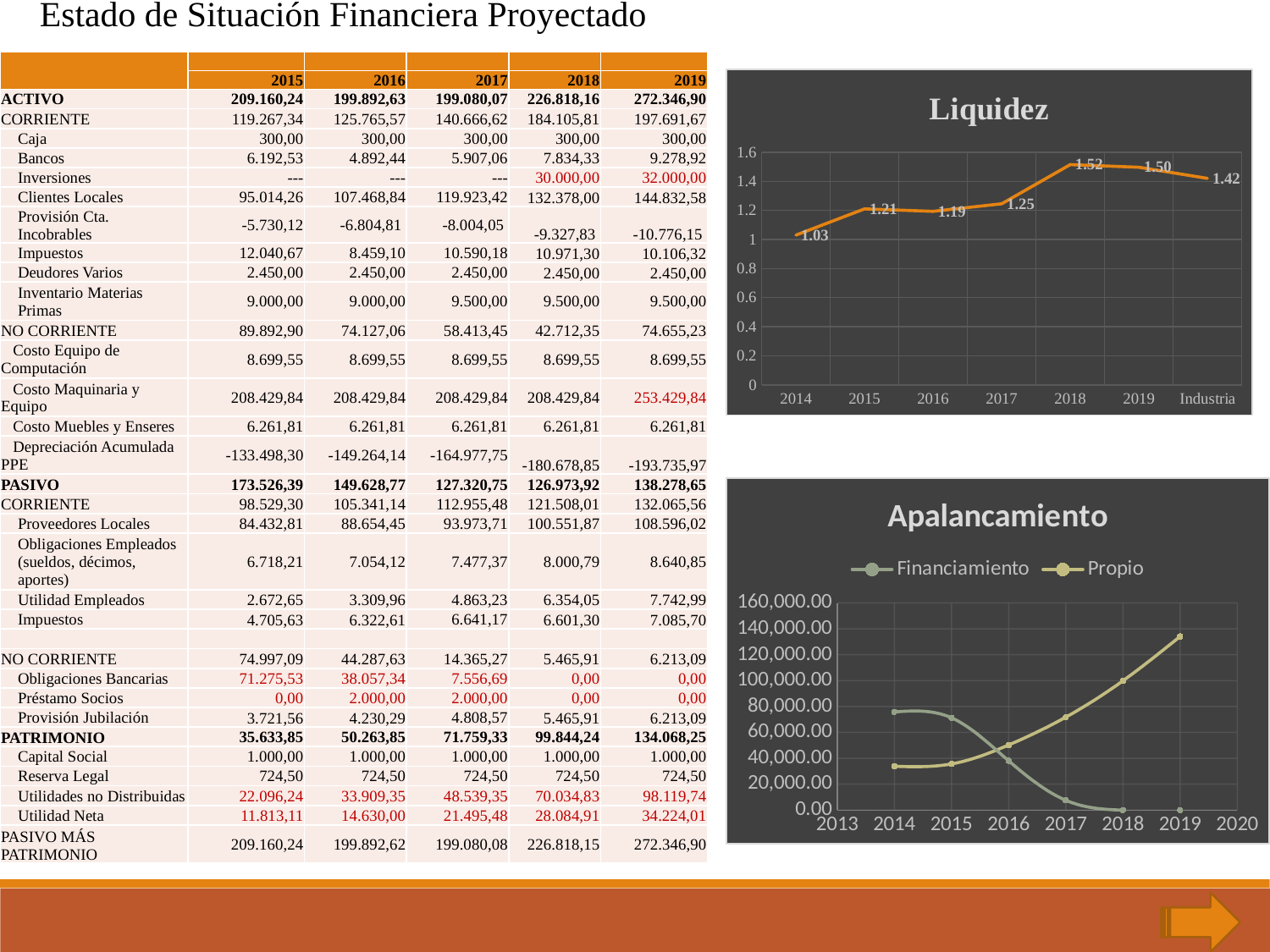
In the Liquidez chart, which is larger, the value for 2016 or the value for 2017? 2017 In the Liquidez chart, which category has the lowest value? 2014 In the Apalancamiento chart, how many series does the legend list? 2 What kind of chart is the Apalancamiento chart? Line chart In the Liquidez chart, which category has the highest value? 2018 In the Liquidez chart, what is the value for Industria? 1.42 In the Apalancamiento chart, does the Financiamiento series rise or fall from 2014 to 2019? Fall In the Liquidez chart, how many data points are plotted? 7 In the Liquidez chart, what is the value for 2014? 1.03 In the Apalancamiento chart, is the value for Propio in 2019 greater or less than 120,000.00? greater In the Liquidez chart, what is the difference between the values for 2018 and 2014? 0.49 In the Apalancamiento chart, which series has the larger value in 2014, Financiamiento or Propio? Financiamiento